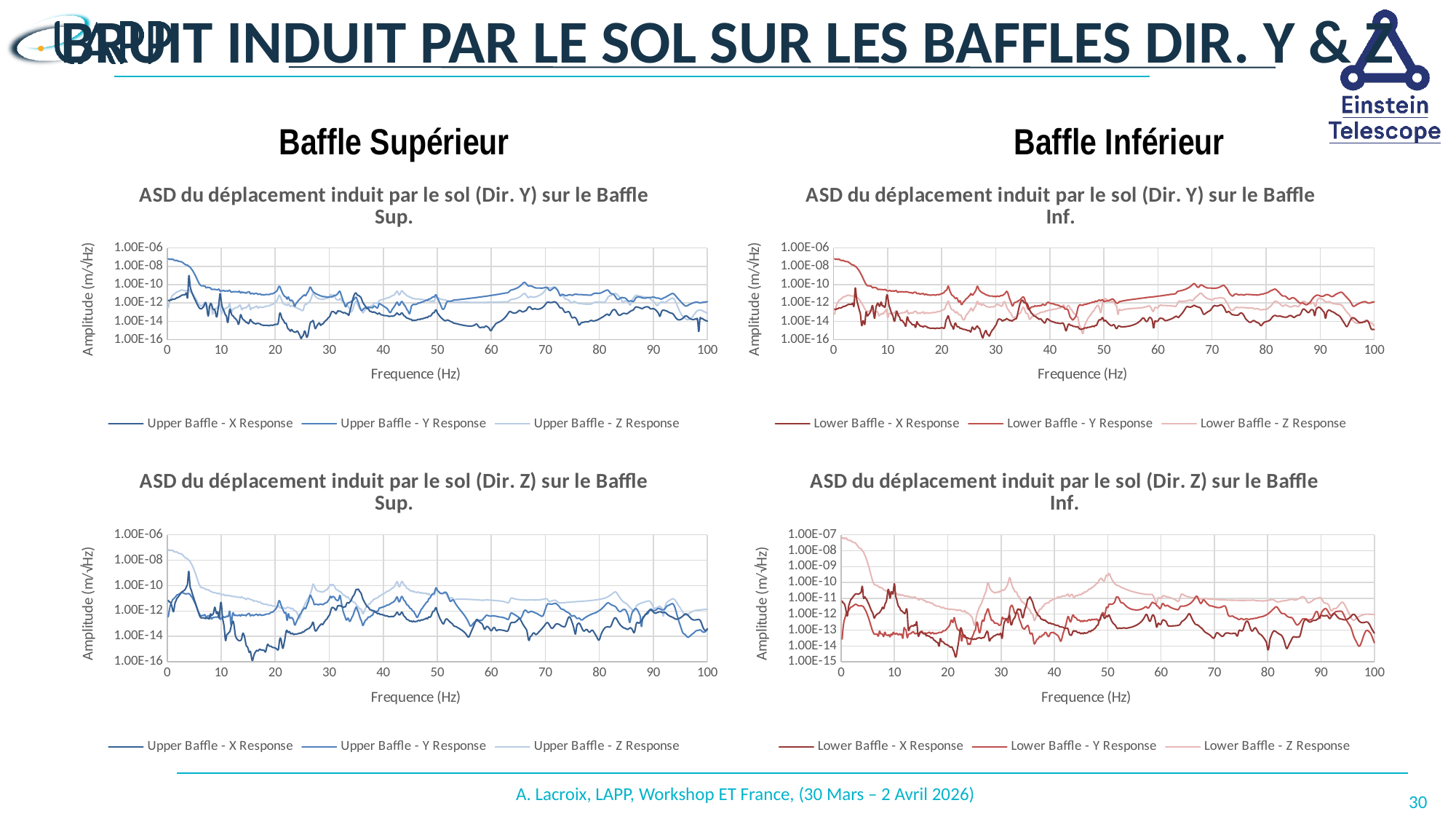
In the bottom-left chart (Dir. Z, Baffle Sup.), is the value of Upper Baffle - Z Response at 0 Hz greater or less than 1.00E-10? greater In the top-left chart (Dir. Y, Baffle Sup.), is the value of Upper Baffle - Y Response at 0 Hz greater or less than 1.00E-10? greater In the bottom-left chart (Dir. Z, Baffle Sup.), which is larger at 0 Hz: Upper Baffle - Z Response or Upper Baffle - X Response? Upper Baffle - Z Response What is the x-axis label of the bottom-right chart (Dir. Z, Baffle Inf.)? Frequence (Hz) In the top-left chart (Dir. Y, Baffle Sup.), which is larger at 0 Hz: Upper Baffle - Y Response or Upper Baffle - X Response? Upper Baffle - Y Response What kind of chart is the top-left chart titled 'ASD du déplacement induit par le sol (Dir. Y) sur le Baffle Sup.'? Line chart In the bottom-right chart (Dir. Z, Baffle Inf.), is the value of Lower Baffle - Z Response at 0 Hz greater or less than 1.00E-09? greater In the bottom-right chart (Dir. Z, Baffle Inf.), which series has the highest value at 0 Hz? Lower Baffle - Z Response In the bottom-left chart (Dir. Z, Baffle Sup.), what are the three series named in the legend? Upper Baffle - X Response, Upper Baffle - Y Response, Upper Baffle - Z Response In the top-right chart (Dir. Y, Baffle Inf.), does the Lower Baffle - Y Response rise or fall between 0 Hz and 10 Hz? fall In the bottom-left chart (Dir. Z, Baffle Sup.), does the Upper Baffle - Z Response rise or fall between 0 Hz and 10 Hz? fall How many series does the legend of the top-right chart (Dir. Y, Baffle Inf.) list? 3